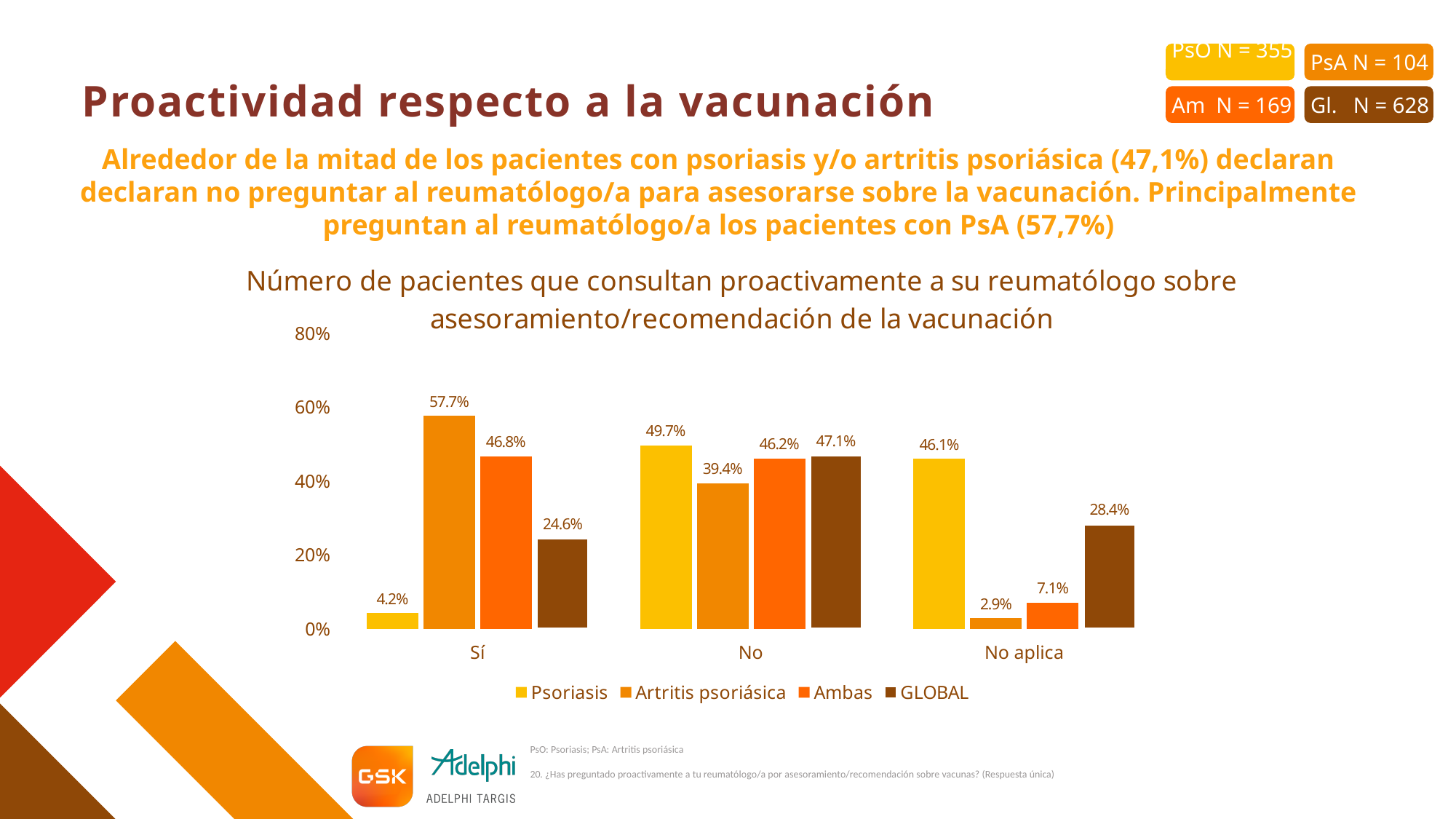
What kind of chart is shown on the slide? Bar chart What is the difference between the Psoriasis value and the Artritis psoriásica value in the No category? 10.3% What is the value for Artritis psoriásica in the Sí category? 57.7% What is the GLOBAL value for the No category? 47.1% Which series has the lowest value in the No aplica category? Artritis psoriásica Which series has the highest value in the Sí category? Artritis psoriásica In the Sí category, which is larger: the Ambas value or the GLOBAL value? Ambas How many categories are shown on the x axis? 3 What is the value for Psoriasis in the No aplica category? 46.1% What is the value for Ambas in the No aplica category? 7.1% Is the Psoriasis value in the Sí category greater or less than 20%? less How many series does the legend list? 4